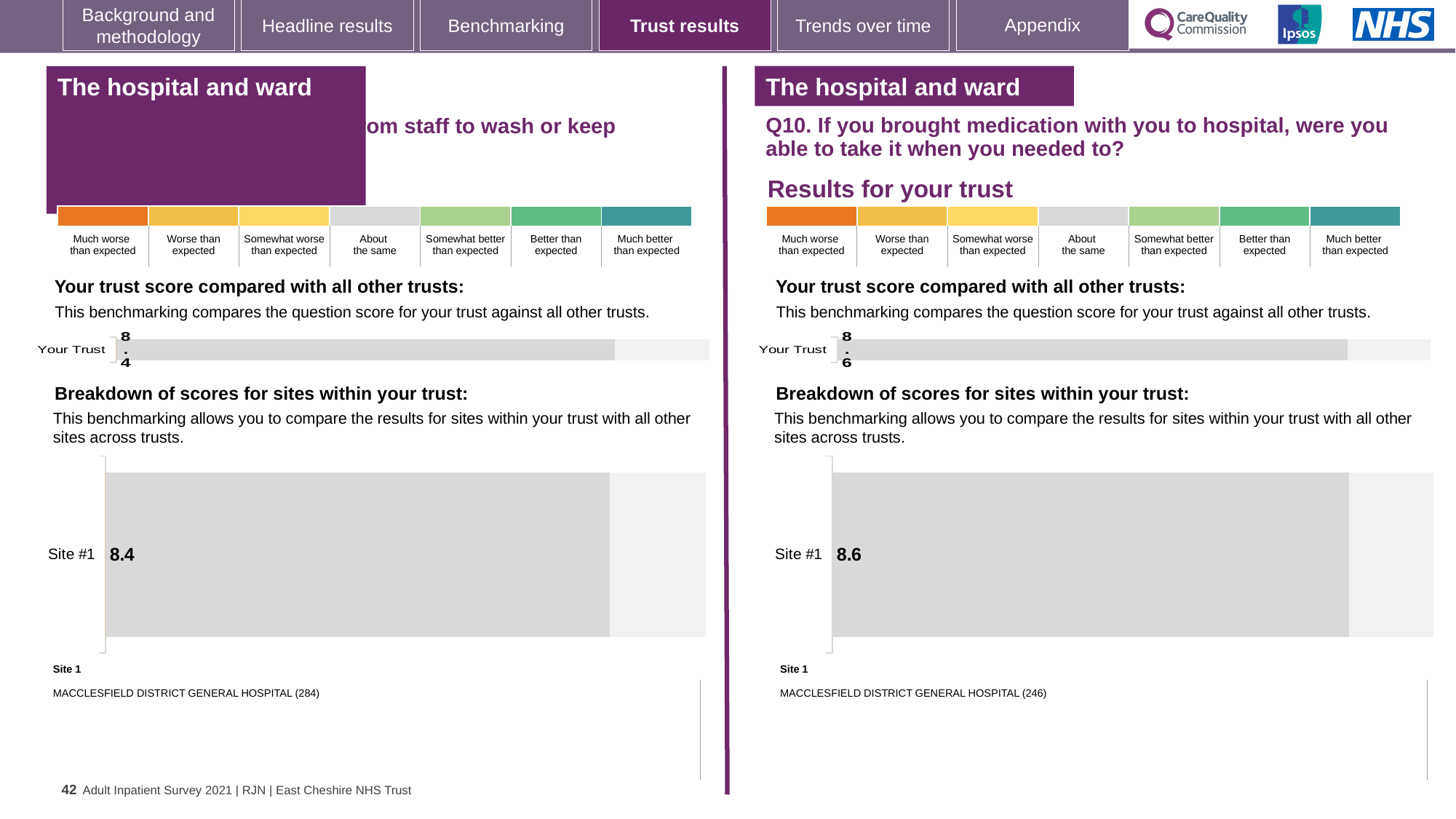
What is the difference between the Site #1 score on the right-hand side (Q10) and the Site #1 score on the left-hand side? 0.2 How many sites are shown in the right-hand 'Breakdown of scores for sites within your trust' chart (Q10)? 1 How many respondents are shown in brackets for Site 1 on the left-hand side of the slide? 284 In the left-hand 'Breakdown of scores for sites within your trust' chart, what is the score for Site #1? 8.4 What type of chart is used to show the Site #1 score on the right-hand side of the slide (Q10)? Bar chart How many sites are shown in the left-hand 'Breakdown of scores for sites within your trust' chart? 1 On the left-hand side of the slide, what is the score shown for Your Trust? 8.4 Which hospital is listed as Site 1 on the right-hand side of the slide (Q10)? MACCLESFIELD DISTRICT GENERAL HOSPITAL (246) Which is larger: the Your Trust score on the left-hand side of the slide or the Your Trust score on the right-hand side (Q10)? Right-hand side (Q10) In the right-hand 'Breakdown of scores for sites within your trust' chart (Q10), what is the score for Site #1? 8.6 On the right-hand side of the slide (Q10, medication), what is the score shown for Your Trust? 8.6